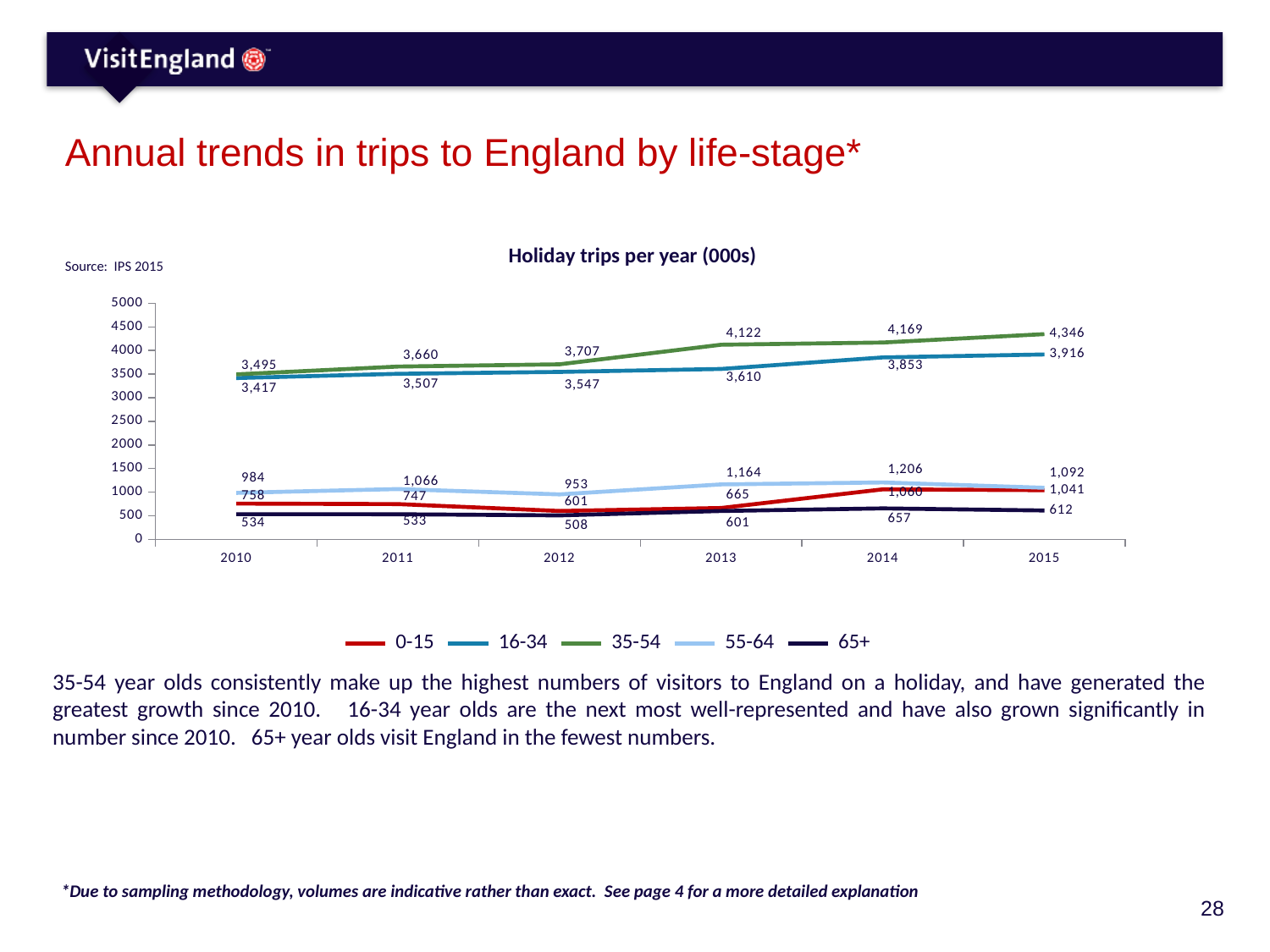
In which year does the 35-54 series reach its highest value? 2015 What is the value for the 65+ series in 2012? 508 In 2013, which is larger: the 55-64 value or the 0-15 value? 55-64 Does the 35-54 series rise or fall from 2010 to 2015? Rises Which series has the lowest value in 2015? 65+ What kind of chart is shown on the slide? Line chart How many series does the legend list? 5 How many years are shown on the x axis? 6 What is the value for the 16-34 series in 2010? 3,417 What is the difference between the 35-54 and 16-34 values in 2015? 430 What is the value for the 35-54 series in 2015? 4,346 What is the value for the 55-64 series in 2014? 1,206